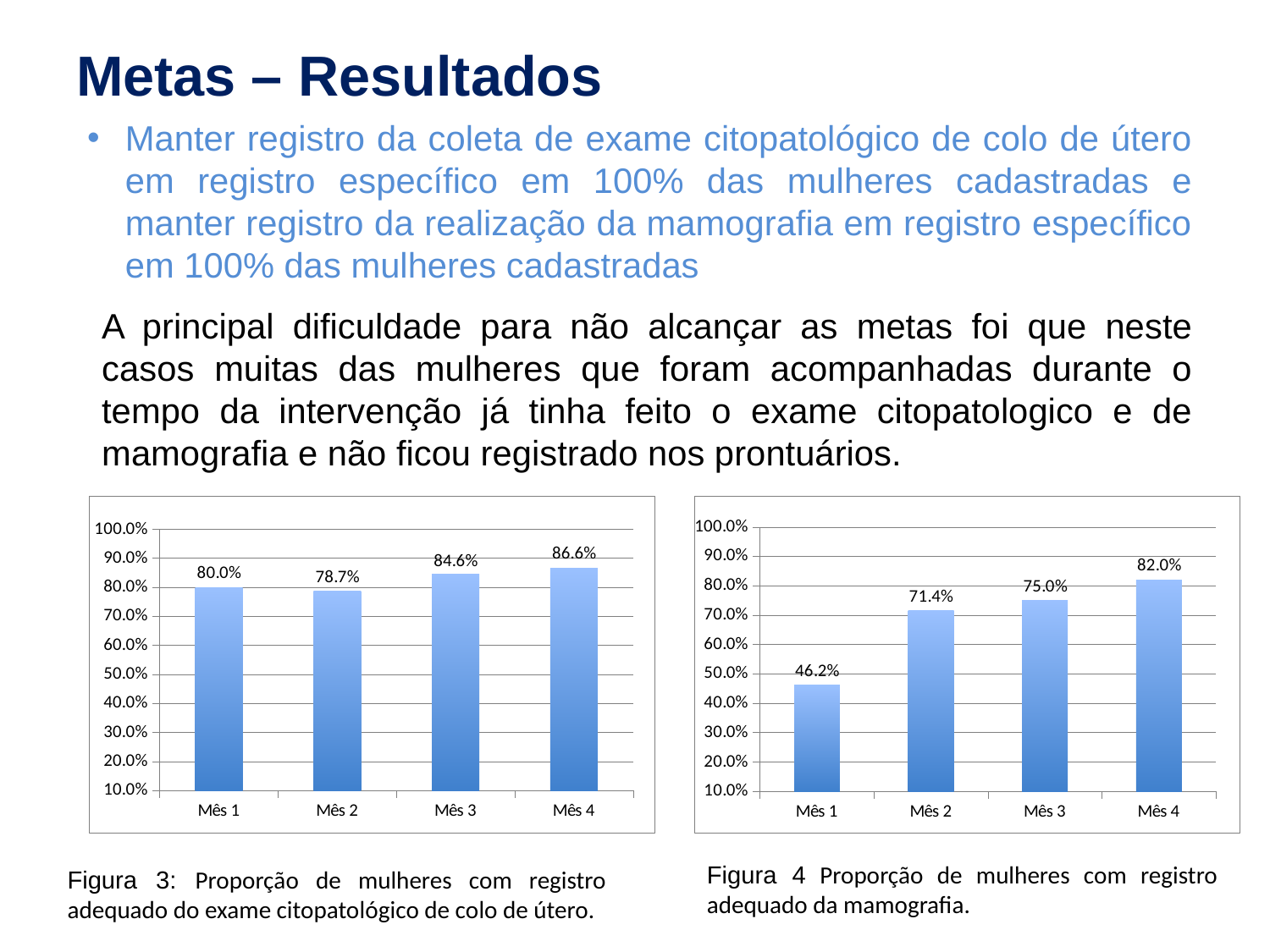
What is the caption of the right chart? Figura 4 Proporção de mulheres com registro adequado da mamografia. In the right chart (Figura 4), which month has the lowest value? Mês 1 What kind of chart is the left chart (Figura 3)? Bar chart How many months are shown on the x axis of the right chart (Figura 4)? 4 In the left chart (Figura 3), what is the value for Mês 2? 78.7% In the left chart (Figura 3), what is the difference between the values for Mês 4 and Mês 3? 2.0% In the left chart (Figura 3), which month has the highest value? Mês 4 In the left chart (Figura 3), which is larger, the value for Mês 1 or Mês 2? Mês 1 In the right chart (Figura 4), what is the difference between the values for Mês 4 and Mês 1? 35.8% In the right chart (Figura 4), what is the value for Mês 1? 46.2% In the right chart (Figura 4), is the value for Mês 2 greater or less than 70.0%? greater In the right chart (Figura 4), do the values rise or fall from Mês 1 to Mês 4? Rise